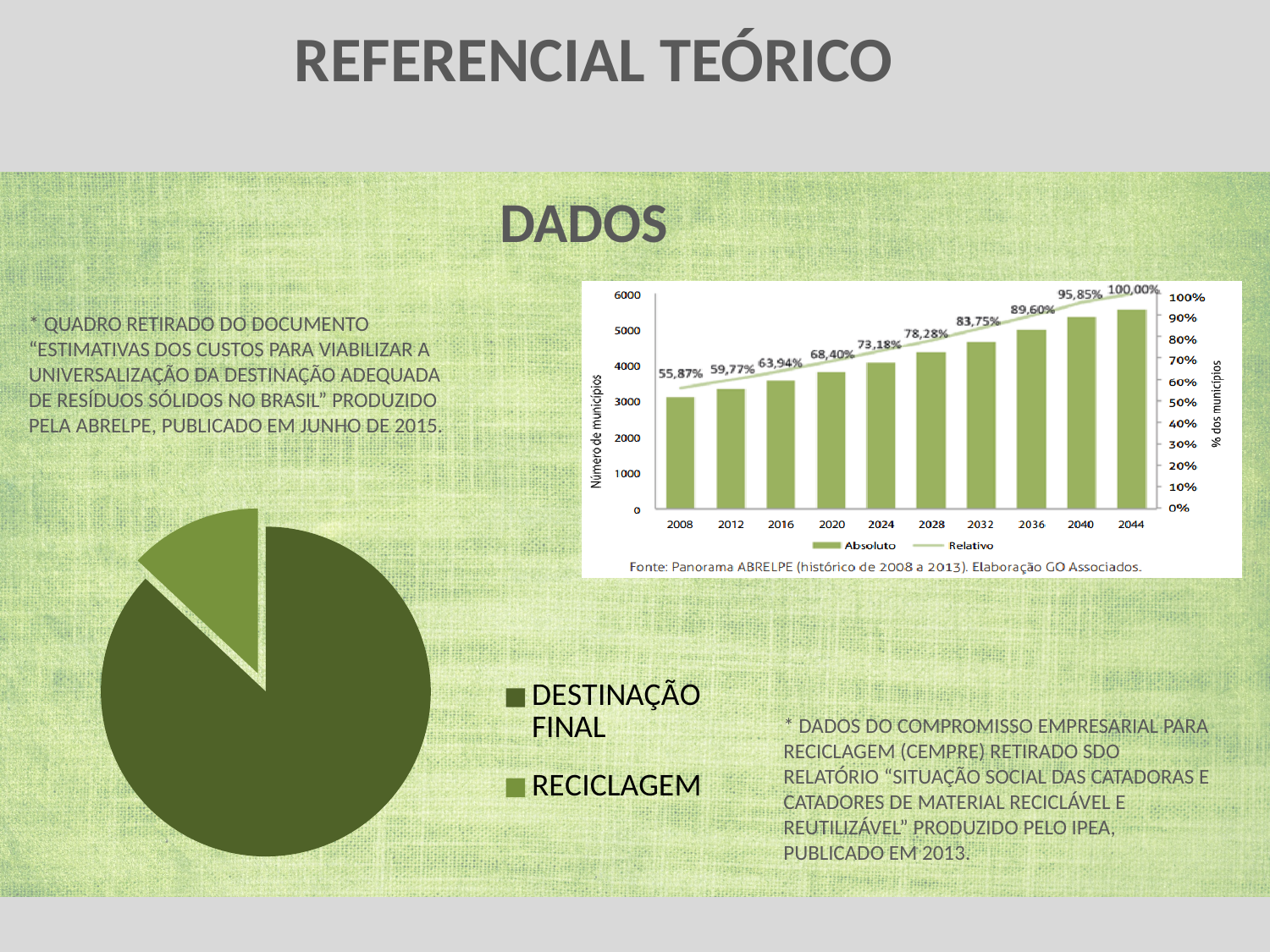
In the top-right chart, what is the Relativo value for 2008? 55,87% In the top-right chart, how many series does the legend list? 2 In the top-right chart, what is the Relativo value for 2028? 78,28% In the top-right chart, is the Absoluto value for 2008 greater or less than 4000? less In the top-right chart, is the Absoluto value for 2044 greater or less than 5000? greater In the top-right chart, what is the Relativo value for 2044? 100,00% In the top-right chart, which year has the lowest Relativo value? 2008 In the top-right chart, does the Relativo line rise or fall from 2008 to 2044? rise In the top-right chart, how many years are shown on the x axis? 10 In the bottom-left pie chart, which slice is larger, DESTINAÇÃO FINAL or RECICLAGEM? DESTINAÇÃO FINAL What kind of chart is shown at the bottom left of the slide? pie chart In the top-right chart, which year has the highest Relativo value? 2044